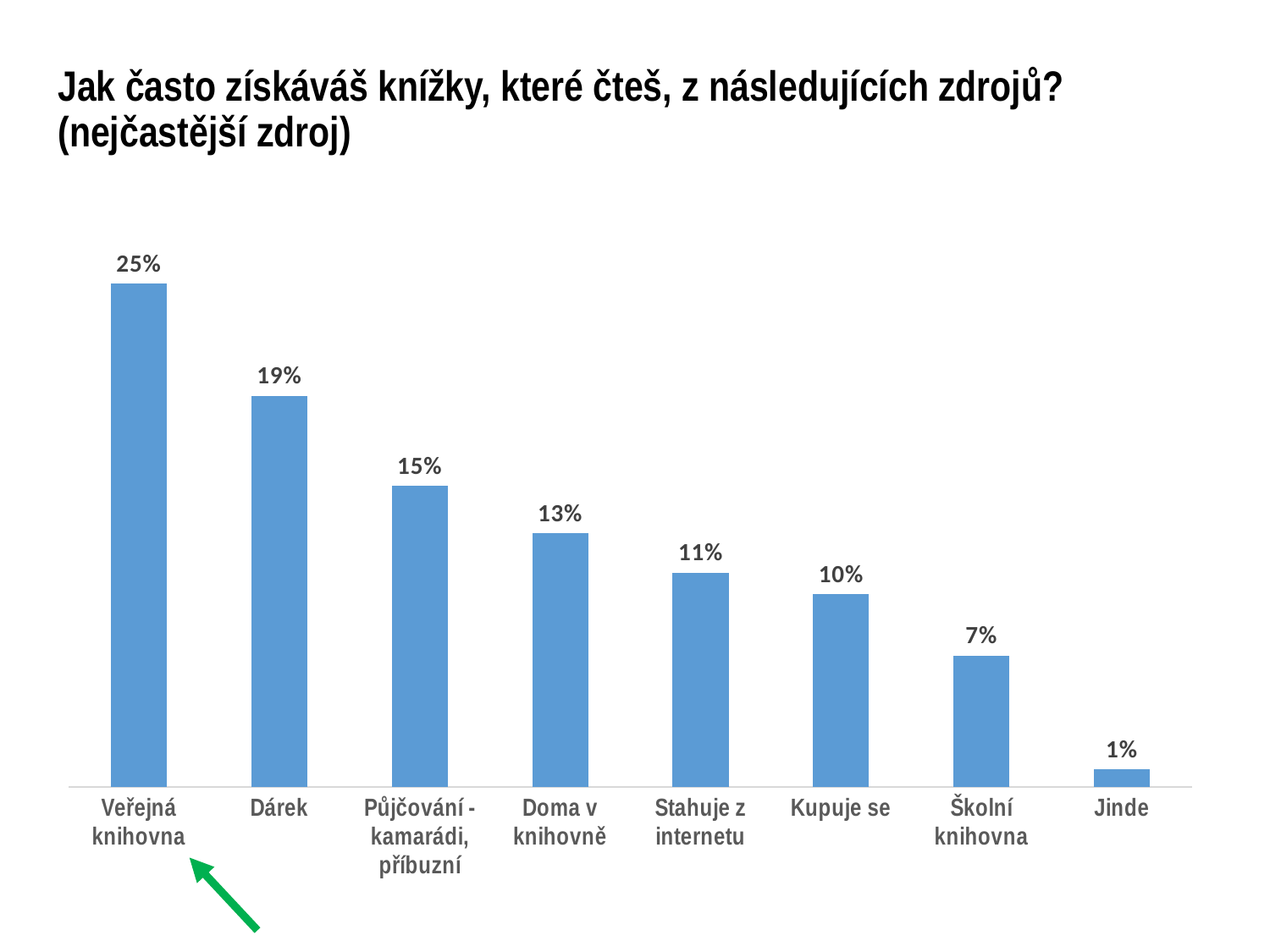
What is the difference between the values for Veřejná knihovna and Dárek? 6% Which is larger, the value for Půjčování - kamarádi, příbuzní or the value for Kupuje se? Půjčování - kamarádi, příbuzní Do the values rise or fall from left to right along the x axis? fall What is the value for Veřejná knihovna? 25% What is the difference between the values for Doma v knihovně and Kupuje se? 3% How many categories are shown on the chart? 8 Which category does the green arrow on the slide point to? Veřejná knihovna What kind of chart is shown on the slide? bar chart What is the value for Školní knihovna? 7% Which category has the highest value? Veřejná knihovna What is the value for Stahuje z internetu? 11% Which category has the lowest value? Jinde